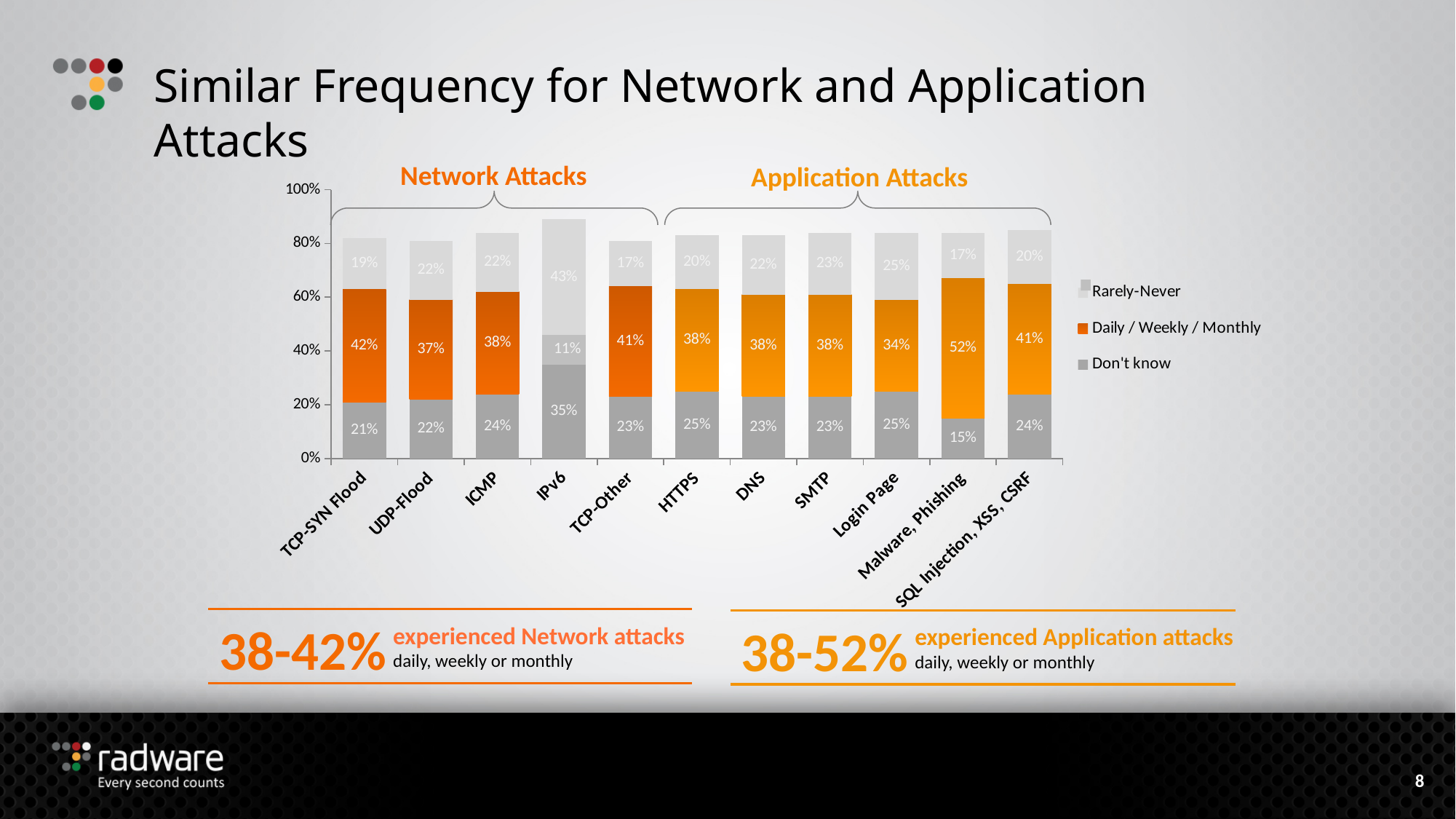
Which category has the highest Daily / Weekly / Monthly value? Malware, Phishing What is the Rarely-Never value for Malware, Phishing? 17% Which two groups are labelled above the chart? Network Attacks and Application Attacks What is the difference between the Daily / Weekly / Monthly values for Malware, Phishing and Login Page? 18% Which has a larger Rarely-Never value, IPv6 or ICMP? IPv6 How many series does the legend list? 3 What is the Daily / Weekly / Monthly value for TCP-SYN Flood? 42% What is the Don't know value for IPv6? 35% How many categories are shown on the x axis? 11 What is the total of the stacked bar for TCP-SYN Flood? 82% Which category has the lowest Daily / Weekly / Monthly value? IPv6 What kind of chart is shown on the slide? Stacked bar chart